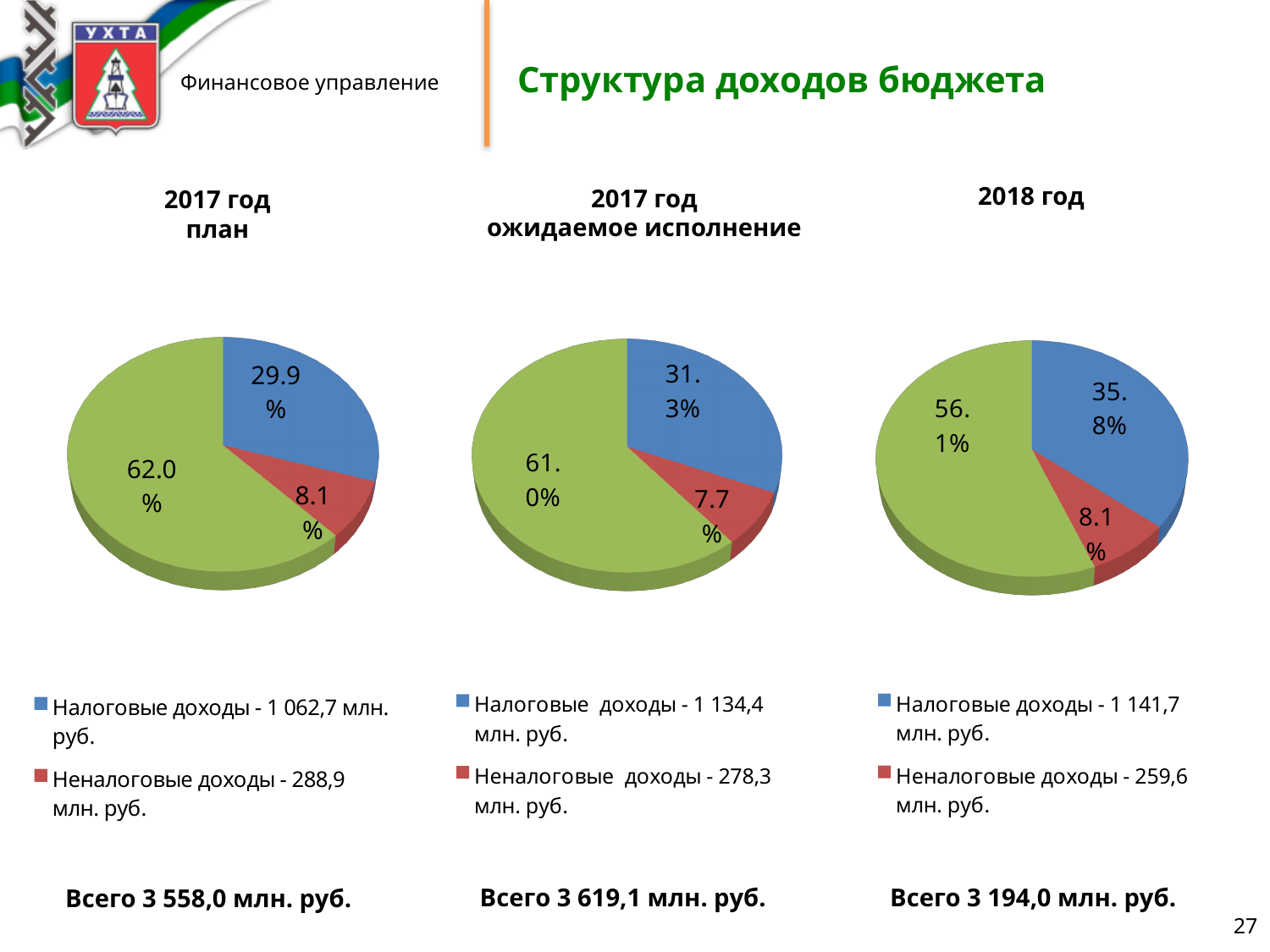
In the '2017 год ожидаемое исполнение' chart, what share is shown for Налоговые доходы? 31.3% How many entries does the legend of the '2018 год' chart list? 2 What kind of chart is used for the '2017 год план' chart? Pie chart In the '2018 год' chart, what share is shown for Налоговые доходы? 35.8% In the '2018 год' chart, what is the difference between the Налоговые доходы share and the Неналоговые доходы share? 27.7% How many slices does the '2017 год ожидаемое исполнение' pie chart have? 3 Which is larger: the Налоговые доходы share in the '2017 год план' chart or in the '2018 год' chart? 2018 год In the '2017 год план' chart, what share is shown for Налоговые доходы? 29.9% In the '2018 год' chart, what is the largest slice's share? 56.1% In the '2017 год план' chart, what share is shown for Неналоговые доходы? 8.1% In the '2017 год план' chart, which slice is the smallest? Неналоговые доходы In the '2017 год ожидаемое исполнение' chart, what share is shown for Неналоговые доходы? 7.7%